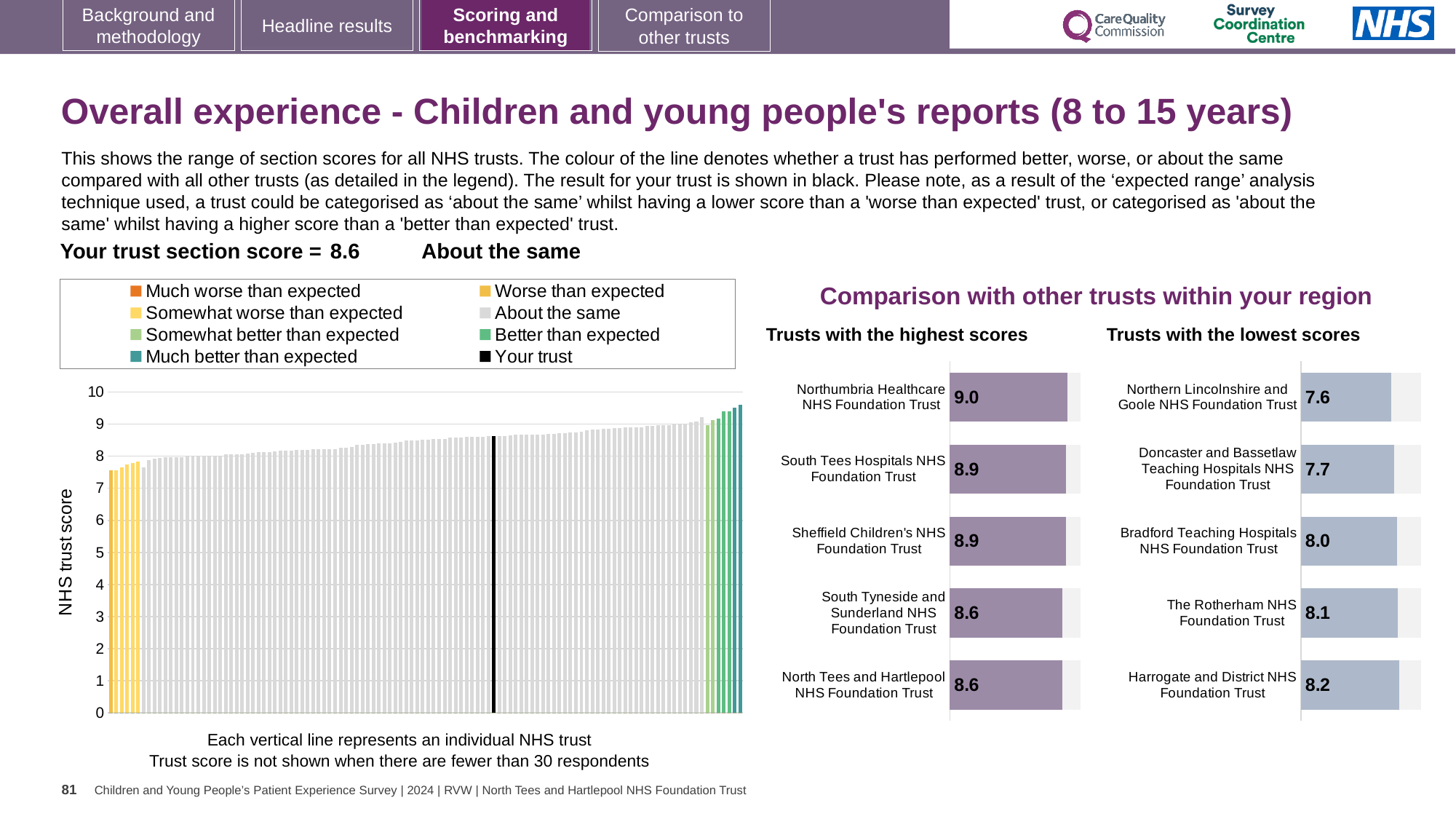
In the 'Trusts with the highest scores' chart, what is the score for South Tyneside and Sunderland NHS Foundation Trust? 8.6 In the 'Trusts with the lowest scores' chart, which trust has the lowest score? Northern Lincolnshire and Goole NHS Foundation Trust In the 'Trusts with the lowest scores' chart, what is the score for Bradford Teaching Hospitals NHS Foundation Trust? 8.0 How many trusts are listed in the 'Trusts with the lowest scores' chart? 5 In the 'Trusts with the highest scores' chart, what is the score for Northumbria Healthcare NHS Foundation Trust? 9.0 What kind of chart is the large chart on the left showing NHS trust scores? Bar chart In the large chart on the left, do the trust scores rise or fall from left to right? Rise How many entries does the legend of the large chart on the left list? 8 In the 'Trusts with the lowest scores' chart, which has the higher score: The Rotherham NHS Foundation Trust or Doncaster and Bassetlaw Teaching Hospitals NHS Foundation Trust? The Rotherham NHS Foundation Trust In the 'Trusts with the highest scores' chart, what is the difference between the scores of Northumbria Healthcare NHS Foundation Trust and North Tees and Hartlepool NHS Foundation Trust? 0.4 In the 'Trusts with the lowest scores' chart, what is the difference between the scores of Harrogate and District NHS Foundation Trust and Northern Lincolnshire and Goole NHS Foundation Trust? 0.6 In the 'Trusts with the highest scores' chart, which trust has the highest score? Northumbria Healthcare NHS Foundation Trust